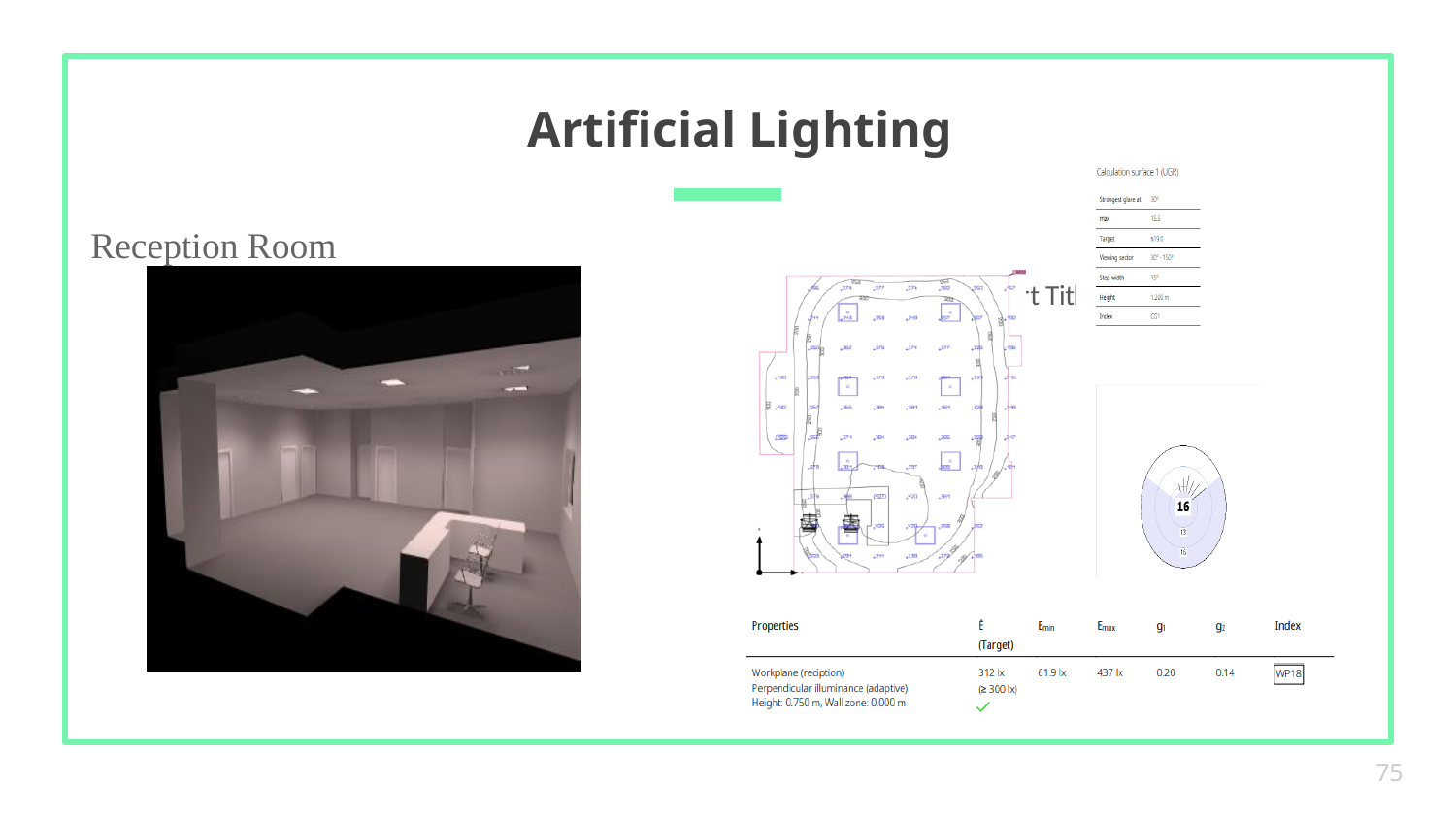
In the results table at the bottom of the slide, what is the Emax value for the Workplane (reception)? 437 lx In the results table at the bottom of the slide, is the Ē (Target) value of 312 lx greater or less than the 300 lx requirement shown? greater In the results table at the bottom of the slide, what is the Emin value for the Workplane (reception)? 61.9 lx In the results table at the bottom of the slide, what is the difference between Emax and Emin for the Workplane (reception)? 375.1 lx Which room does the slide say the lighting calculation is for? Reception Room In the results table at the bottom of the slide, which is larger for the Workplane (reception): Emax or Emin? Emax In the results table at the bottom of the slide, what is the g1 value for the Workplane (reception)? 0.20 In the results table at the bottom of the slide, what is the Ē (Target) value for the Workplane (reception)? 312 lx In the polar glare diagram on the right of the slide, what number is printed at its centre? 16 In the results table at the bottom of the slide, what Index is given for the Workplane (reception)? WP18 In the results table at the bottom of the slide, what is the g2 value for the Workplane (reception)? 0.14 What is the title of the slide? Artificial Lighting